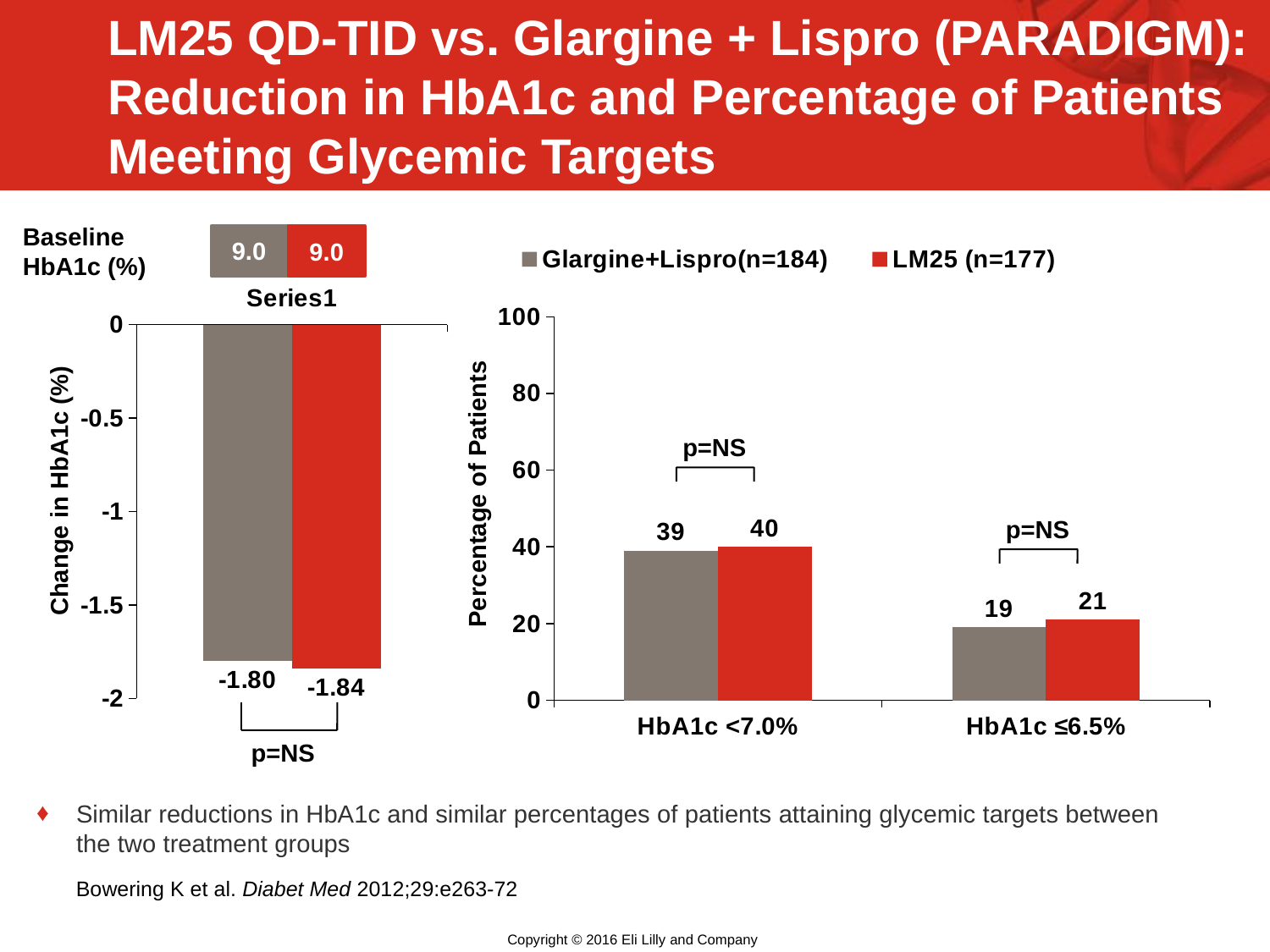
In the right-hand chart (Percentage of Patients), how many series does the legend list? 2 In the right-hand chart (Percentage of Patients), which group has the higher value for HbA1c ≤6.5%, Glargine+Lispro or LM25? LM25 In the right-hand chart (Percentage of Patients), what percentage of Glargine+Lispro patients reached HbA1c <7.0%? 39 In the right-hand chart (Percentage of Patients), which category has the lowest value for Glargine+Lispro? HbA1c ≤6.5% In the right-hand chart (Percentage of Patients), what is the difference between the LM25 and Glargine+Lispro values for HbA1c <7.0%? 1 In the left-hand chart (Change in HbA1c), what is the change in HbA1c for the red (LM25) bar? -1.84 In the left-hand chart (Change in HbA1c), what is the change in HbA1c for the grey (Glargine+Lispro) bar? -1.80 In the right-hand chart (Percentage of Patients), is the LM25 value for HbA1c <7.0% greater or less than 60? less In the right-hand chart (Percentage of Patients), what percentage of LM25 patients reached HbA1c ≤6.5%? 21 In the right-hand chart (Percentage of Patients), how many categories are shown on the x axis? 2 What type of chart is the right-hand chart (Percentage of Patients)? bar chart In the right-hand chart (Percentage of Patients), what is the sample size shown in the legend for LM25? n=177